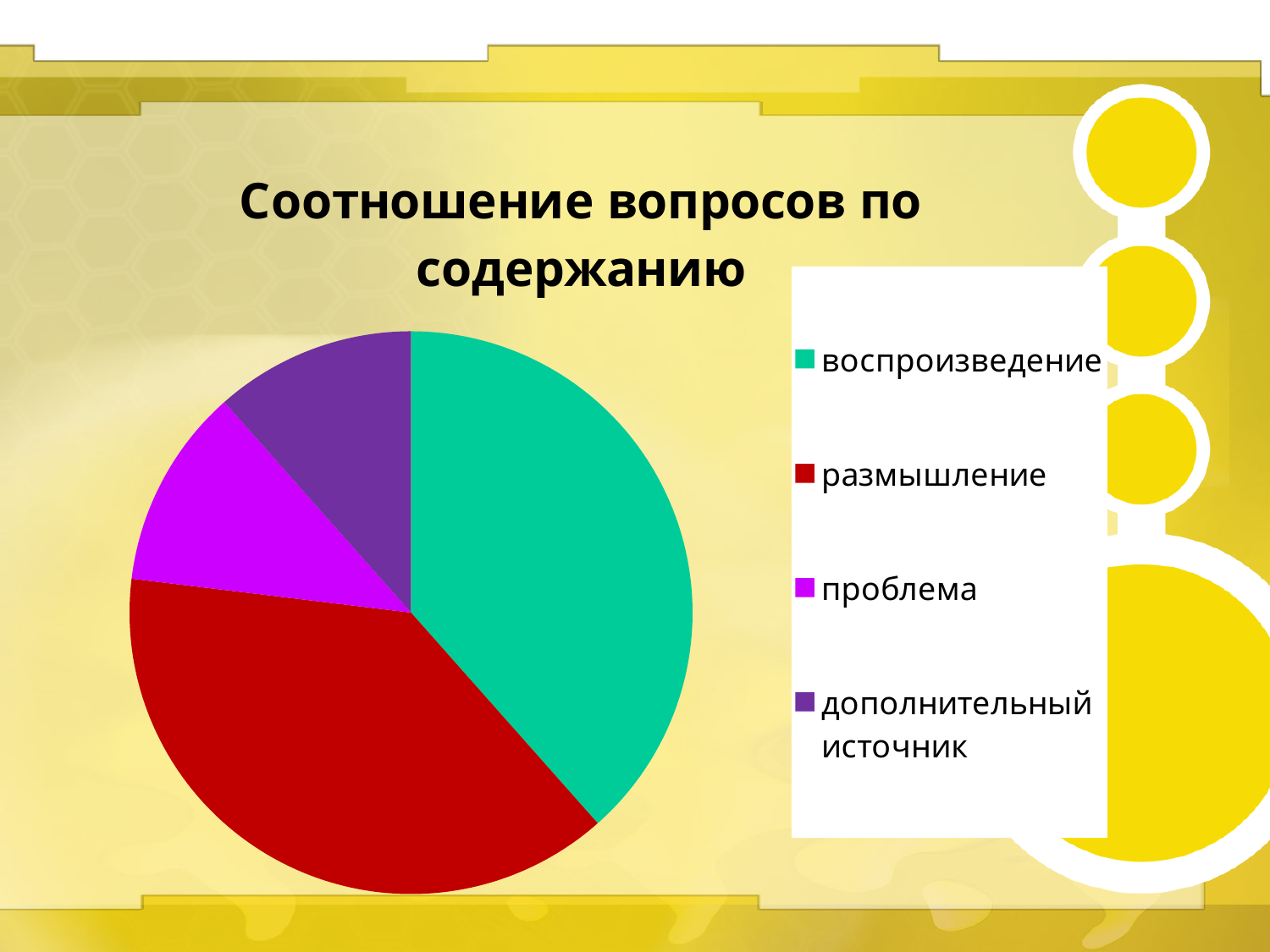
How many slices does the pie chart have? 4 Which slice is larger in the pie chart: "дополнительный источник" or "воспроизведение"? воспроизведение Which slice is larger in the pie chart: "размышление" or "дополнительный источник"? размышление Which colour represents the category "размышление" in the pie chart? red How many entries does the legend of the pie chart list? 4 Which slice is larger in the pie chart: "воспроизведение" or "проблема"? воспроизведение What is the title of the pie chart? Соотношение вопросов по содержанию What kind of chart is shown on the slide? pie chart